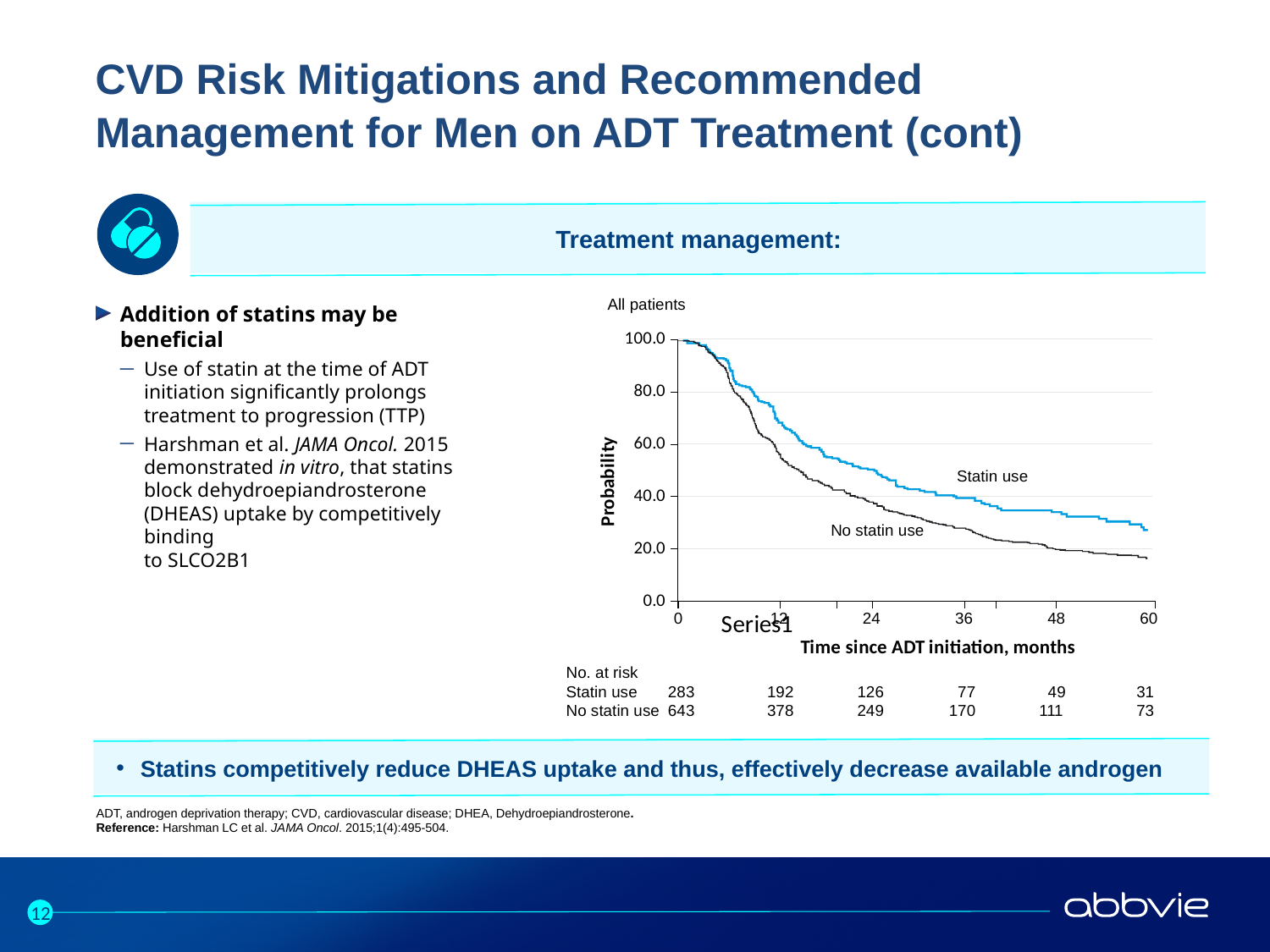
What is the title of the chart's x axis? Time since ADT initiation, months How many patients were at risk in the Statin use group at 0 months? 283 Is the probability for Statin use at 12 months greater or less than 60.0? greater How many curves are plotted on the chart? 2 What is the title of the chart's y axis? Probability What is the difference between the number at risk for No statin use and Statin use at 0 months? 360 Is the probability for Statin use at 60 months greater or less than 40.0? less Is the probability for No statin use at 36 months greater or less than 40.0? less What kind of chart is shown on the slide? Line chart At 36 months, which curve is higher, Statin use or No statin use? Statin use Do the curves rise or fall as time since ADT initiation increases? Fall How many patients were at risk in the No statin use group at 24 months? 249